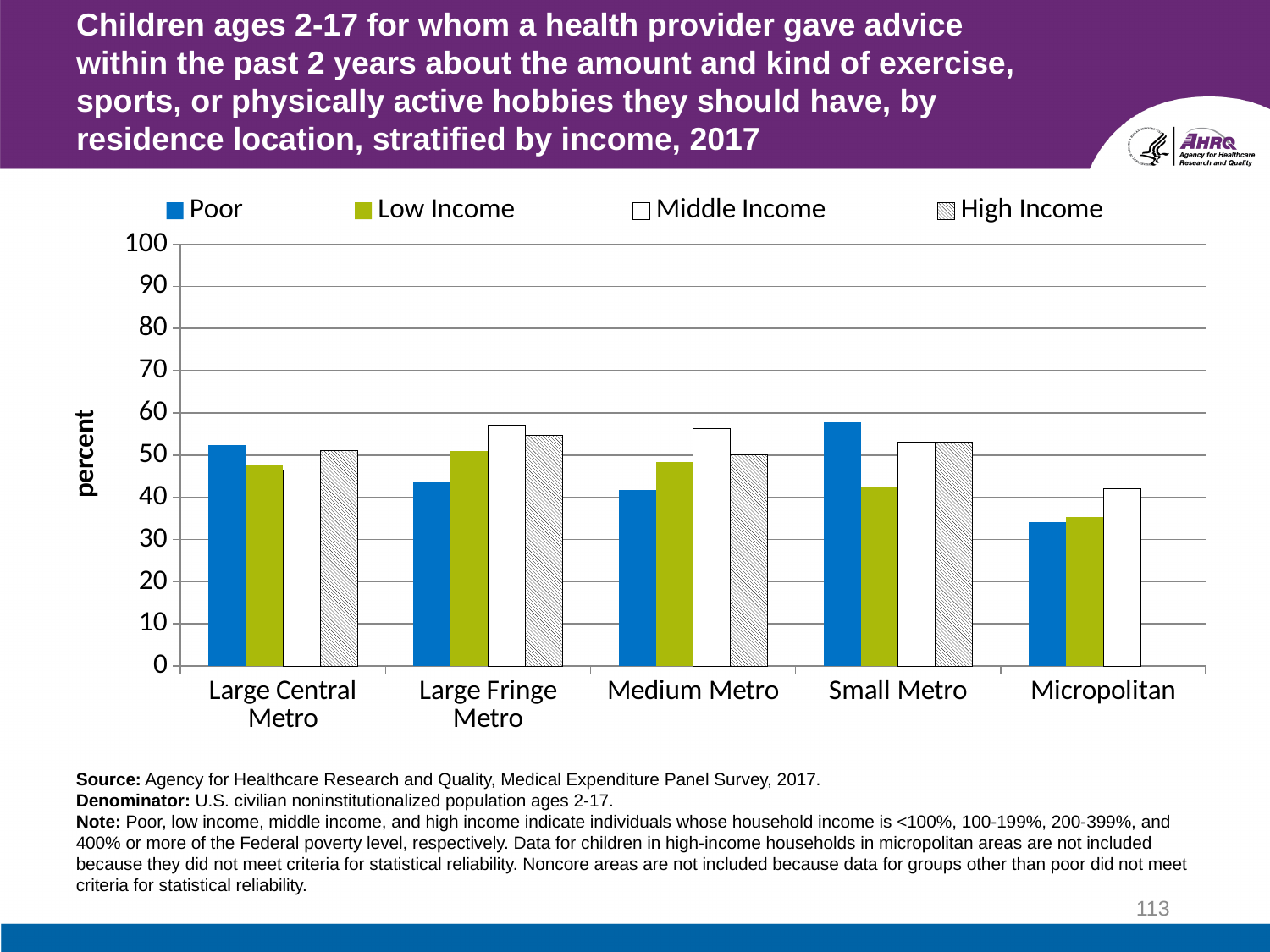
In Small Metro, which is larger: the Poor bar or the Low Income bar? Poor Which residence location has the highest value for Poor? Small Metro Which residence location has the lowest value for Poor? Micropolitan Is the value for Poor in Micropolitan greater or less than 40? less How many residence location categories are shown on the x axis? 5 What is the label on the y axis? percent How many income series does the legend list? 4 Is the value for Low Income in Medium Metro greater or less than 50? less Is the value for Poor in Small Metro greater or less than 50? greater In Medium Metro, which is larger: the Poor bar or the Middle Income bar? Middle Income What kind of chart is shown on the slide? bar chart